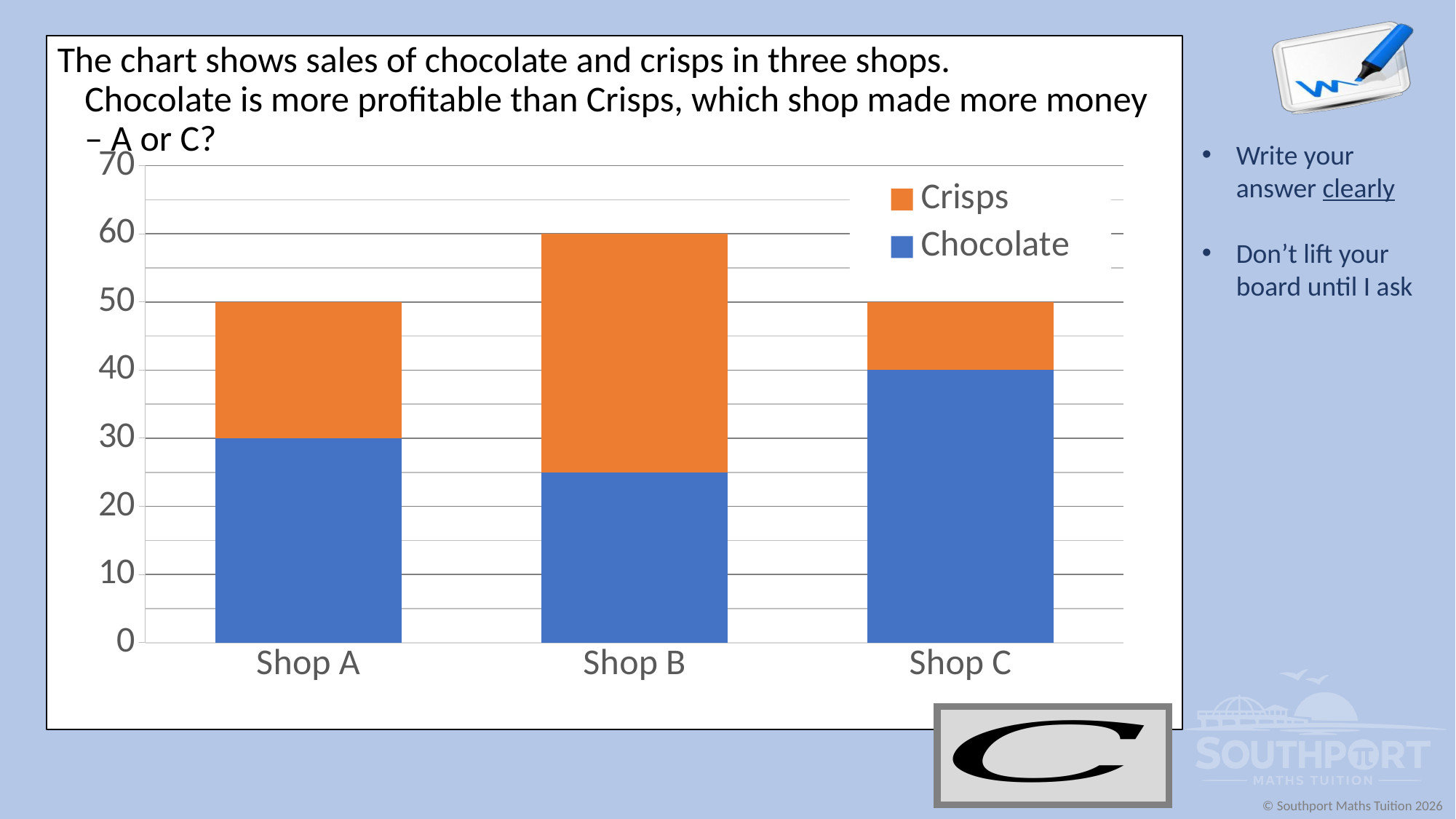
What is the difference between the Chocolate values for Shop C and Shop A? 10 Which shop has the highest total sales? Shop B What is the total height of the stacked bar for Shop A? 50 Which shop has the highest Chocolate sales? Shop C Which is larger, the Chocolate value for Shop A or for Shop C? Shop C What kind of chart is shown on the slide? bar chart How many shops are shown on the x axis? 3 How many series does the legend list? 2 What is the total height of the stacked bar for Shop B? 60 What is the Chocolate value for Shop C? 40 What is the Chocolate value for Shop A? 30 Is the Chocolate value for Shop B greater or less than 30? less